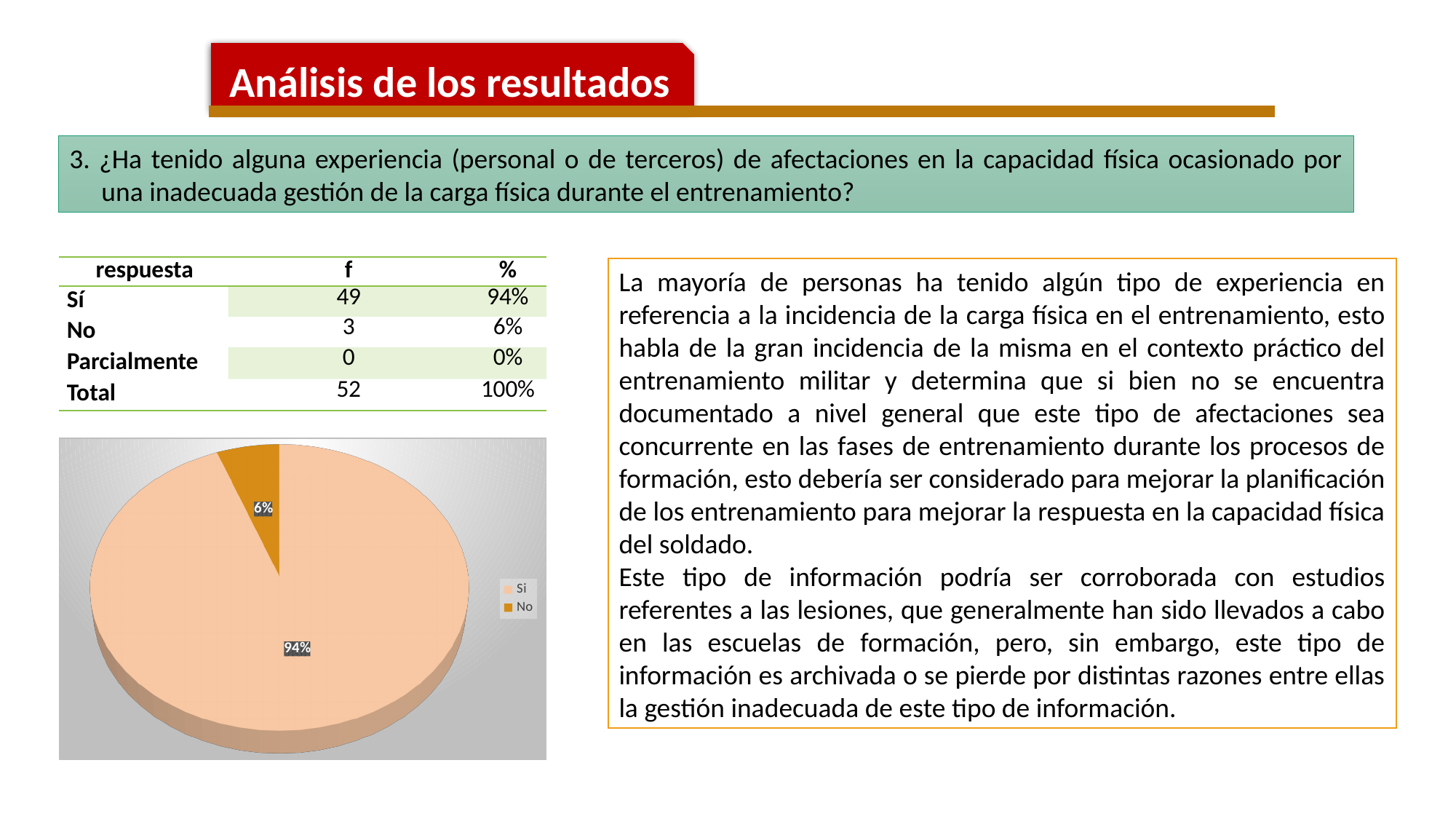
How many entries does the pie chart legend list? 2 What share of the pie does the 'Si' slice represent? 94% What kind of chart is shown on the slide? pie chart How many slices does the pie chart have? 2 What colour is the 'No' slice in the pie chart? orange What share of the pie does the 'No' slice represent? 6% Which is larger in the pie chart, 'Si' or 'No'? Si Which slice of the pie chart is the largest? Si What is the difference in percentage points between the 'Si' and 'No' slices? 88% Is the share of the 'Si' slice greater or less than 50%? greater Which slice of the pie chart is the smallest? No